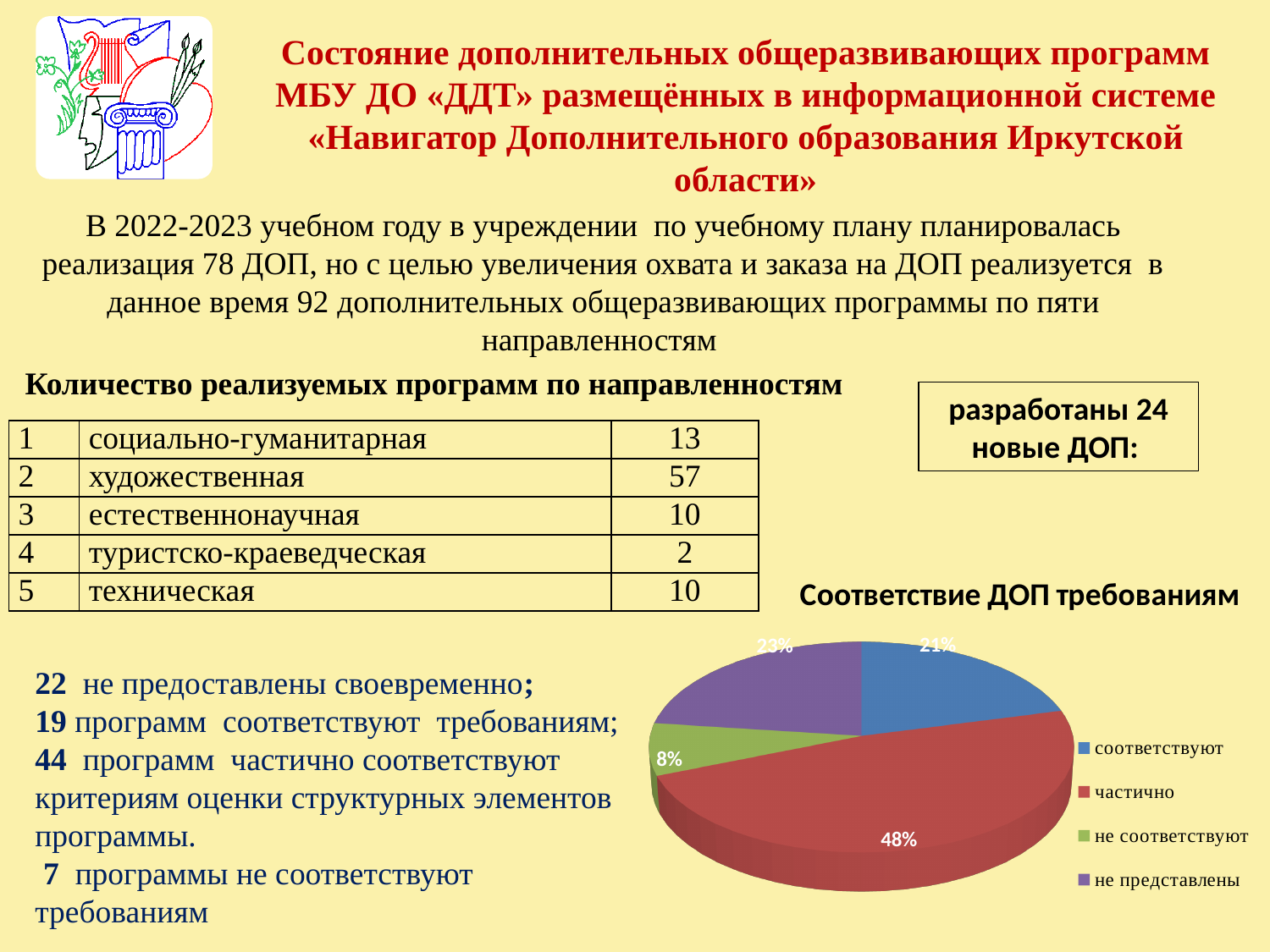
In the pie chart "Соответствие ДОП требованиям", what share is labelled for "не представлены"? 23% In the pie chart "Соответствие ДОП требованиям", what share is labelled for "соответствуют"? 21% In the pie chart "Соответствие ДОП требованиям", which category has the largest slice? частично In the pie chart "Соответствие ДОП требованиям", what share is labelled for "частично"? 48% In the pie chart "Соответствие ДОП требованиям", which category has the smallest slice? не соответствуют In the pie chart "Соответствие ДОП требованиям", what is the difference in percentage points between "частично" and "соответствуют"? 27 How many entries does the legend of the pie chart "Соответствие ДОП требованиям" list? 4 In the pie chart "Соответствие ДОП требованиям", what share is labelled for "не соответствуют"? 8% In the pie chart "Соответствие ДОП требованиям", what colour is the "частично" slice? red What kind of chart is shown under the title "Соответствие ДОП требованиям"? pie chart In the pie chart "Соответствие ДОП требованиям", which is larger: "не представлены" or "соответствуют"? не представлены In the pie chart "Соответствие ДОП требованиям", how many slices are there? 4